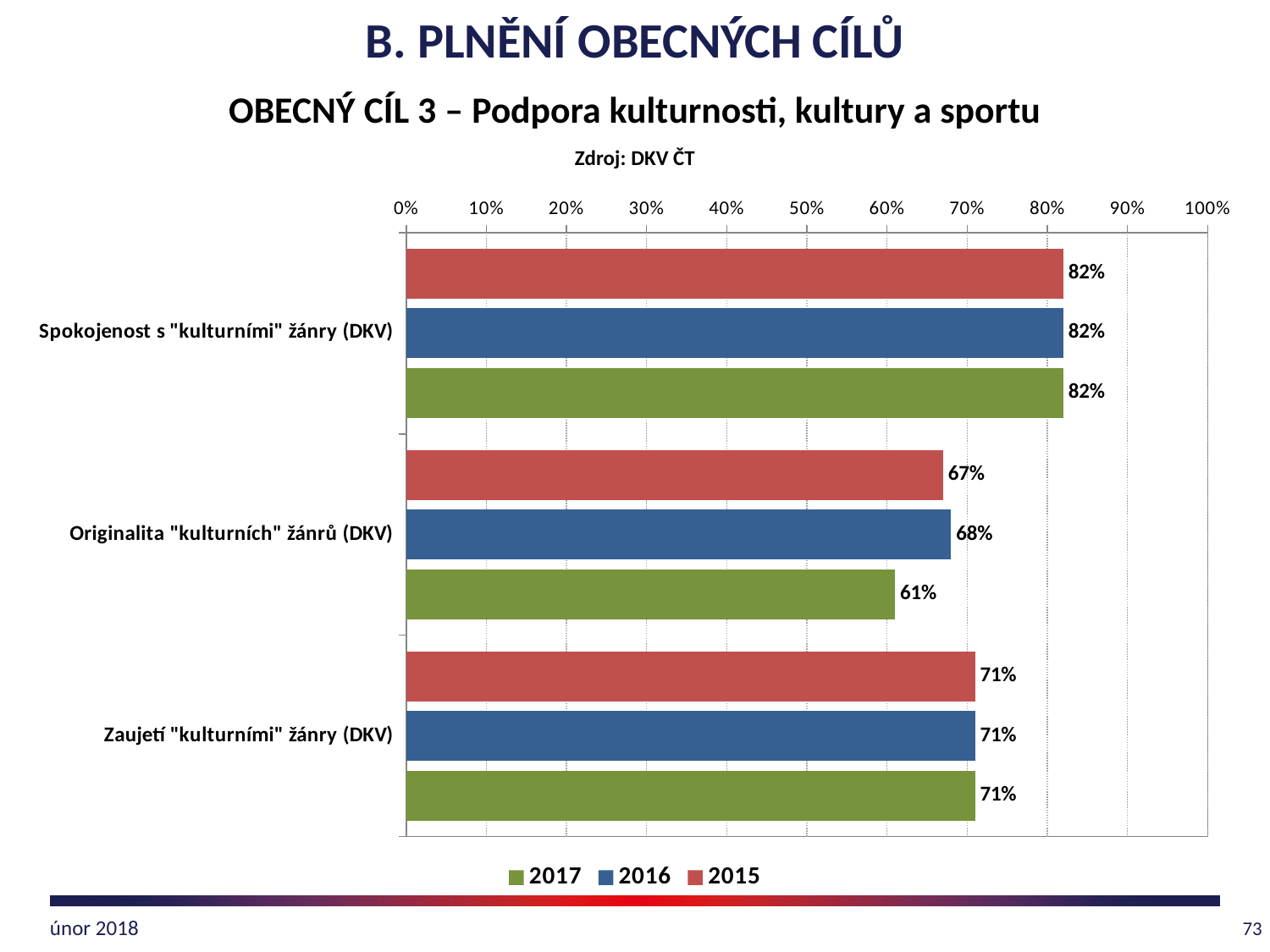
What is the difference between the 2016 and 2017 values for Originalita "kulturních" žánrů (DKV)? 7% For Originalita "kulturních" žánrů (DKV), which is larger: the 2015 value or the 2017 value? 2015 Which colour represents the 2016 series in the legend? Blue What kind of chart is shown on the slide? Bar chart What is the value for 2017 for Originalita "kulturních" žánrů (DKV)? 61% What is the value for 2016 for Originalita "kulturních" žánrů (DKV)? 68% How many series does the legend list? 3 Which category has the highest value for 2017? Spokojenost s "kulturními" žánry (DKV) What is the value for 2015 for Spokojenost s "kulturními" žánry (DKV)? 82% How many categories are shown on the chart? 3 What is the value for 2017 for Zaujetí "kulturními" žánry (DKV)? 71% Which category has the lowest value for 2016? Originalita "kulturních" žánrů (DKV)